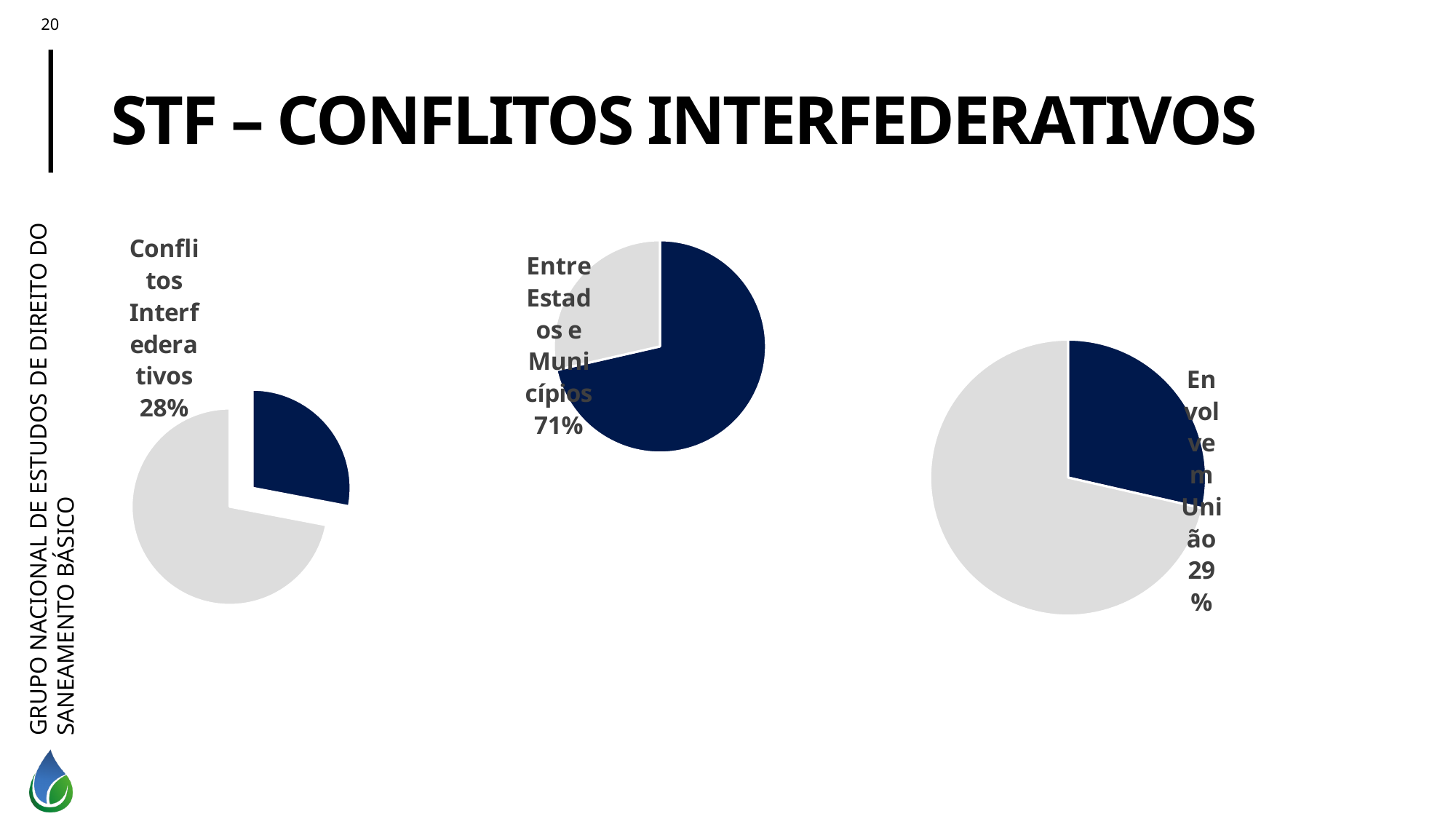
In the right pie chart, which slice is larger, the dark blue 'Envolvem União' slice or the grey slice? The grey slice What kind of chart is the left chart on the slide? Pie chart In the middle pie chart, how many slices are there? 2 Which of the three pie charts has the smallest labelled dark blue share? The left chart (Conflitos Interfederativos, 28%) In the right pie chart, what percentage is shown for the 'Envolvem União' slice? 29% In the left pie chart, what percentage is shown for the 'Conflitos Interfederativos' slice? 28% How many pie charts are shown on the slide? 3 What is the title of the slide containing the three pie charts? STF – CONFLITOS INTERFEDERATIVOS Which of the three pie charts has the largest labelled dark blue share? The middle chart (Entre Estados e Municípios, 71%) What is the difference between the 'Entre Estados e Municípios' share in the middle chart and the 'Envolvem União' share in the right chart? 42% In the middle pie chart, which slice is larger, the dark blue 'Entre Estados e Municípios' slice or the grey slice? The dark blue 'Entre Estados e Municípios' slice In the middle pie chart, what percentage is shown for the 'Entre Estados e Municípios' slice? 71%